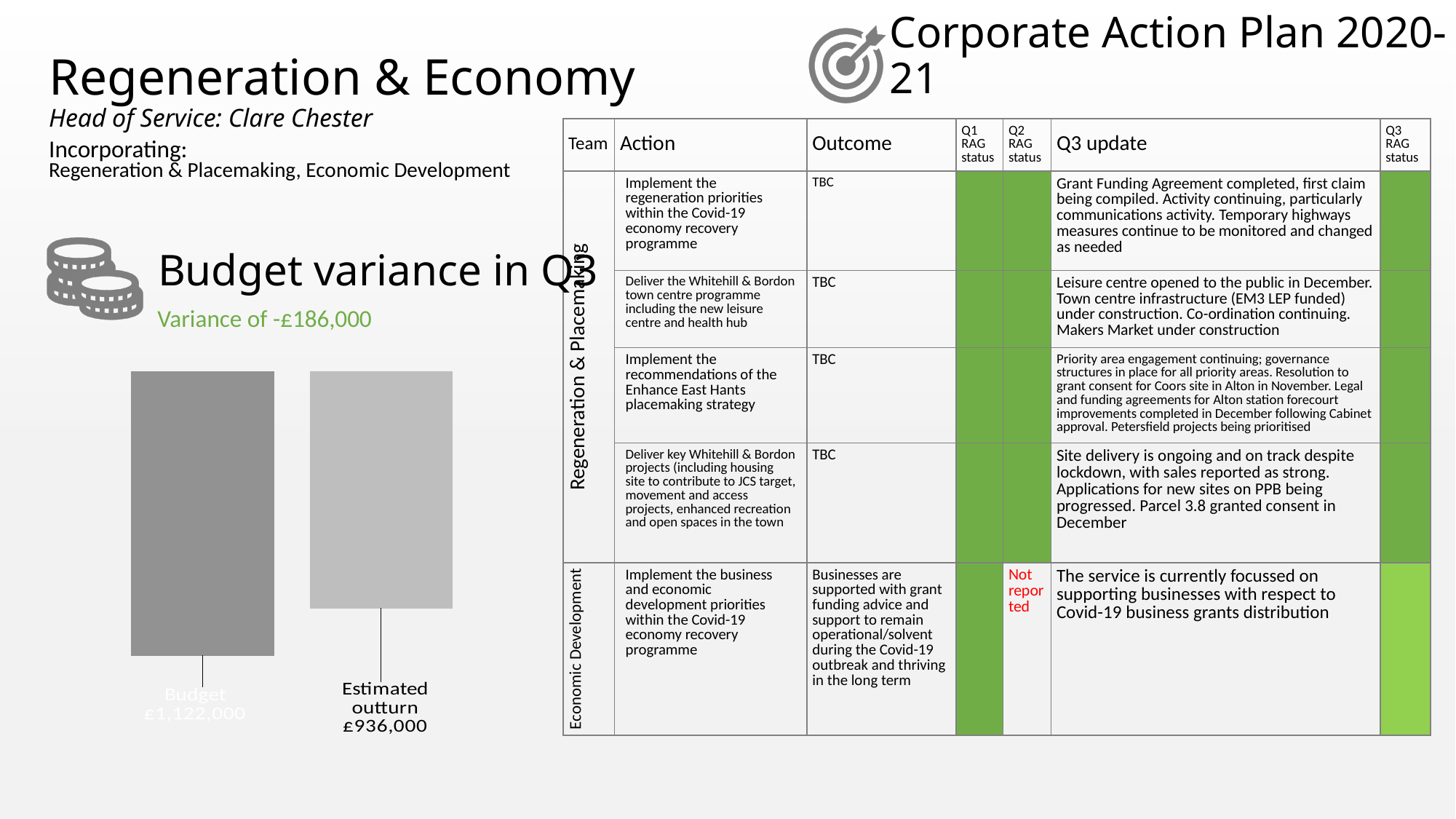
How many bars are shown in the Budget variance in Q3 chart? 2 What is the value of the Estimated outturn bar in the Budget variance in Q3 chart? £936,000 Which category has the lowest value in the Budget variance in Q3 chart? Estimated outturn Do the values fall or rise from the Budget bar to the Estimated outturn bar in the Budget variance in Q3 chart? Fall What is the difference between the Budget and the Estimated outturn in the Budget variance in Q3 chart? £186,000 What is the value of the Budget bar in the Budget variance in Q3 chart? £1,122,000 Which bar is taller in the Budget variance in Q3 chart, Budget or Estimated outturn? Budget What type of chart is used to show the Budget variance in Q3? Bar chart What variance figure is stated beneath the Budget variance in Q3 chart title? Variance of -£186,000 What is the title of the chart on the left of the slide? Budget variance in Q3 Which category has the highest value in the Budget variance in Q3 chart? Budget